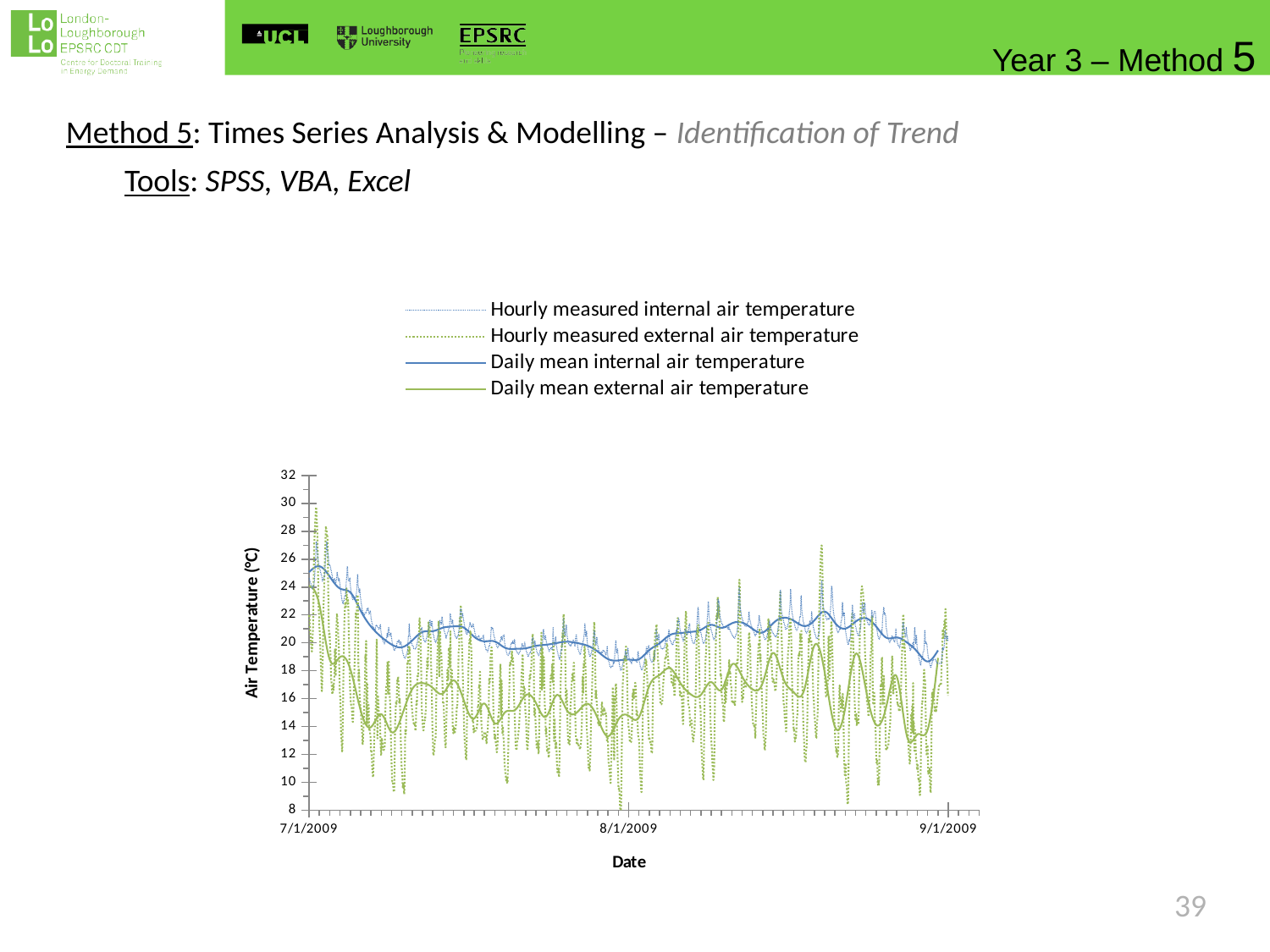
Is the daily mean internal air temperature at 7/1/2009 greater or less than 22? greater What kind of chart is shown on the slide? line chart How many series does the legend list? 4 What is the title of the horizontal axis? Date Is the lowest hourly measured external air temperature greater or less than 10? less What is the title of the vertical axis? Air Temperature (°C) Is the daily mean internal air temperature at 8/1/2009 greater or less than 16? greater Does the daily mean internal air temperature rise or fall between 7/1/2009 and 8/1/2009? fall What is the highest value shown on the vertical axis? 32 Which series is higher throughout the chart, daily mean internal air temperature or daily mean external air temperature? Daily mean internal air temperature